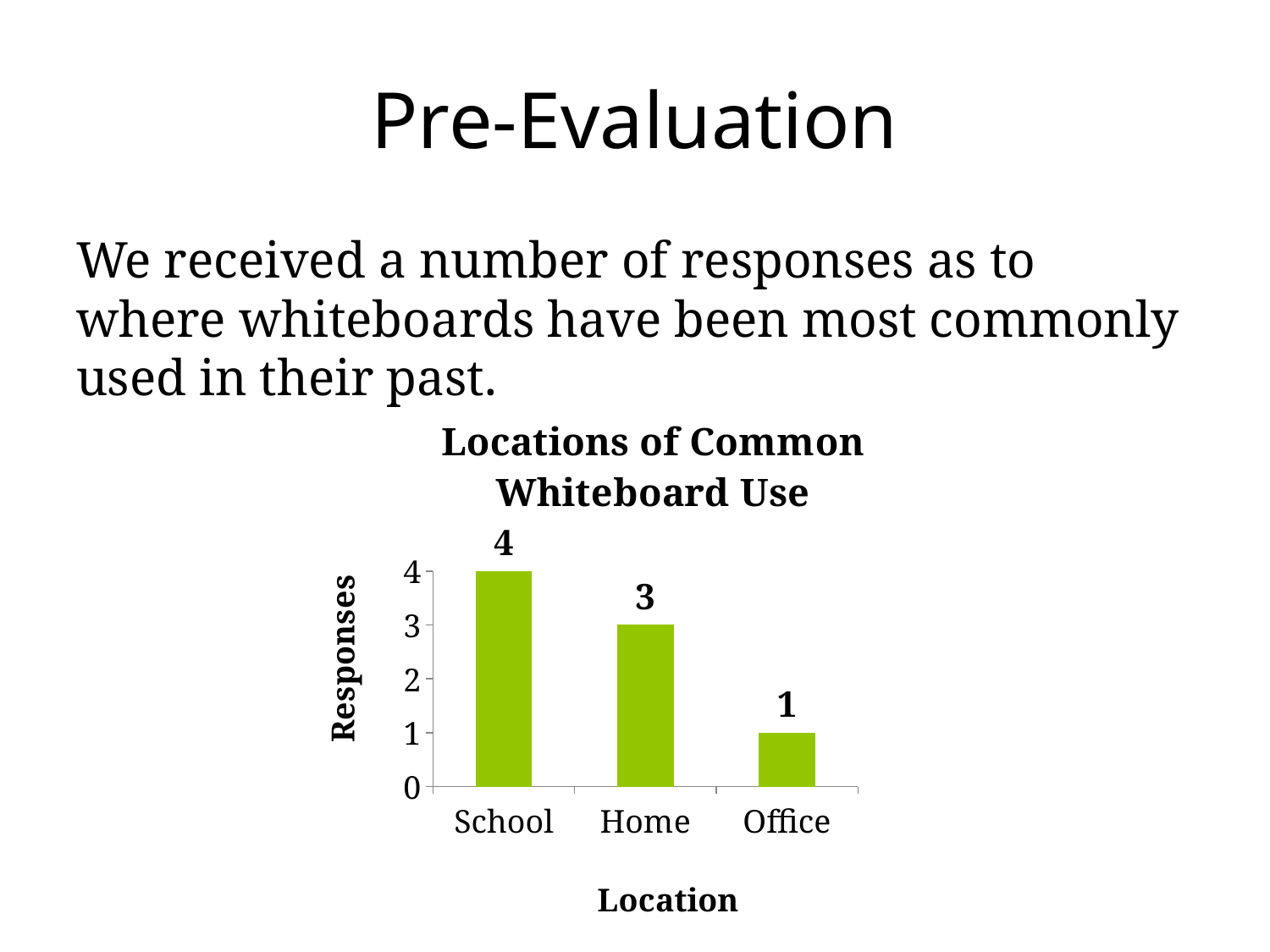
How many locations are shown on the chart? 3 Which location has the highest number of responses? School What is the difference in responses between School and Home? 1 What is the number of responses for School? 4 What is the number of responses for Home? 3 Do the response values rise or fall from School to Office along the x axis? Fall Which location has the lowest number of responses? Office What kind of chart is shown on the slide? Bar chart Which has more responses, Home or Office? Home What is the number of responses for Office? 1 What is the difference in responses between School and Office? 3 What is the title of the chart? Locations of Common Whiteboard Use